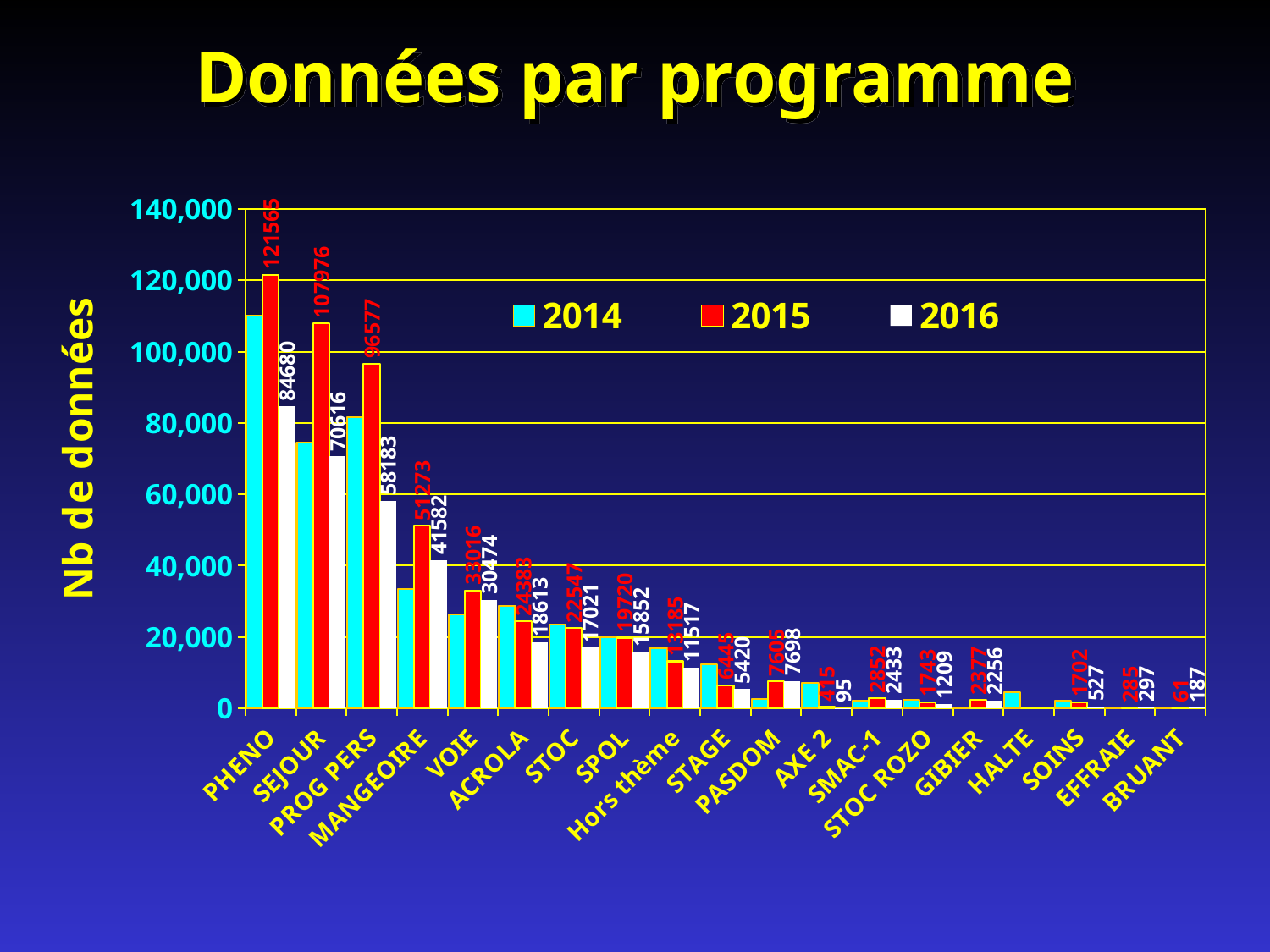
How many categories are shown on the x axis? 19 Which is larger in the 2016 series: MANGEOIRE or VOIE? MANGEOIRE What is the difference between the 2015 and 2016 values for PHENO? 36885 Do the values generally rise or fall from left to right along the x axis? fall What is the difference between the 2015 and 2016 values for SEJOUR? 37360 What kind of chart is shown on the slide? bar chart Is the 2014 value for PHENO greater or less than 100,000? greater What is the value for SEJOUR in the 2016 series? 70616 Which category has the highest value in the 2015 series? PHENO What is the value for BRUANT in the 2016 series? 187 How many series does the legend list? 3 What is the value for PHENO in the 2015 series? 121565